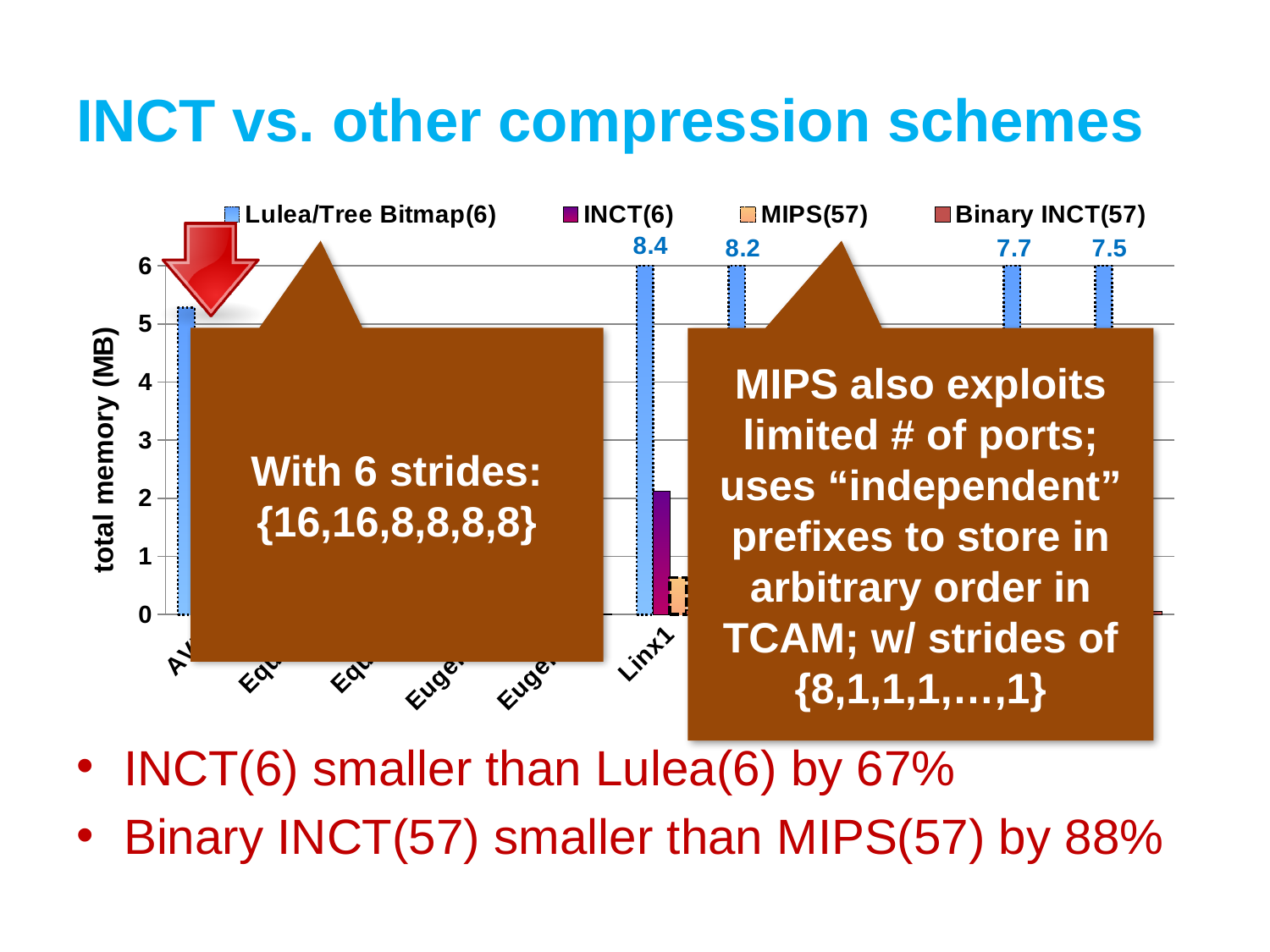
What is the first series listed in the chart legend? Lulea/Tree Bitmap(6) What is the difference between the highest and lowest data labels printed on the chart (8.4 and 7.5)? 0.9 What is the highest value printed as a data label on the chart? 8.4 For Linx1, which is larger: the Lulea/Tree Bitmap(6) bar or the INCT(6) bar? Lulea/Tree Bitmap(6) Is the INCT(6) value for Linx1 greater or less than 3? less How many series does the chart legend list? 4 Is the MIPS(57) value for Linx1 greater or less than 1? less How many data labels are printed above the bars on the chart? 4 What is the Lulea/Tree Bitmap(6) value for Linx1? 8.4 What kind of chart is shown on the slide? bar chart What is the lowest value printed as a data label on the chart? 7.5 What is the title of the chart's vertical axis? total memory (MB)